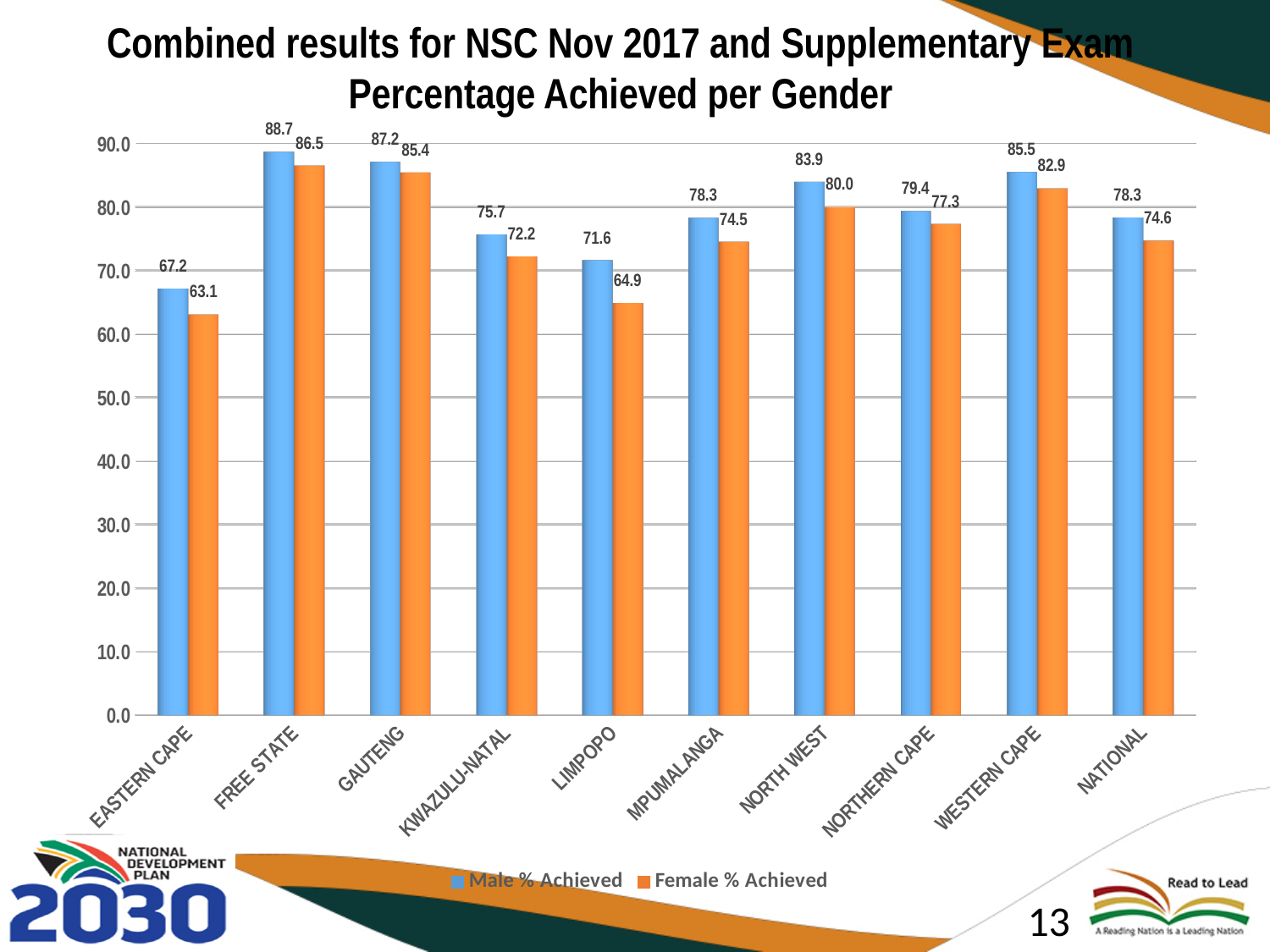
Which province has the highest Male % Achieved? Free State What kind of chart is shown on the slide? Bar chart What is the Female % Achieved for National? 74.6 How many series does the legend list? 2 Which is larger for Gauteng: Male % Achieved or Female % Achieved? Male % Achieved Which province has the lowest Female % Achieved? Eastern Cape Is the Male % Achieved for Eastern Cape greater or less than 70.0? less How many categories are shown on the x axis? 10 What is the Male % Achieved for Free State? 88.7 What is the difference between the Male % Achieved and Female % Achieved for Limpopo? 6.7 Which colour represents Female % Achieved in the chart? Orange What is the Female % Achieved for Limpopo? 64.9